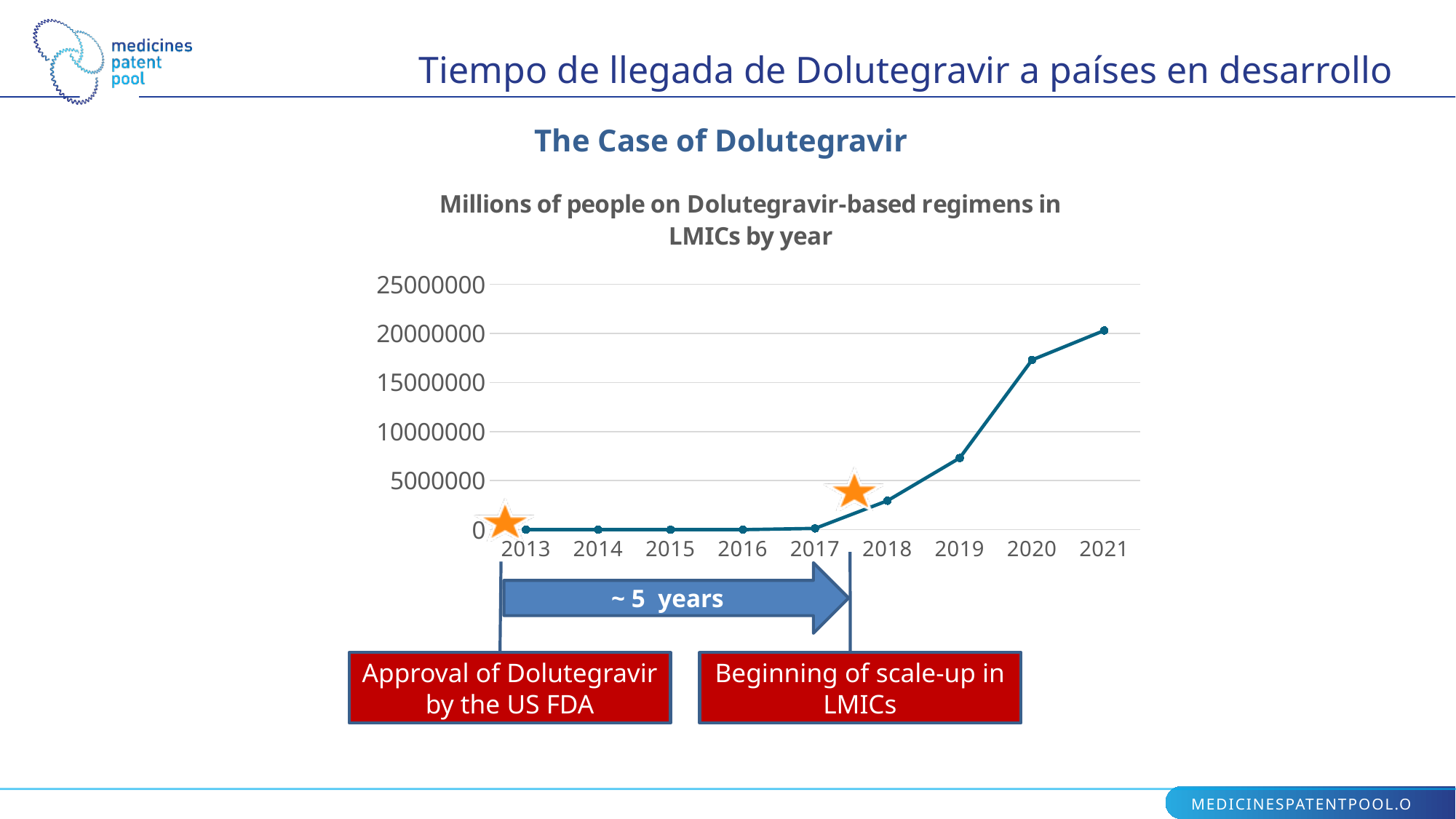
What kind of chart is shown on the slide? line chart Which year has the highest value on the chart? 2021 How many years are plotted along the x axis of the chart? 9 Is the value for 2019 greater or less than 10000000? less Is the value for 2020 greater or less than 15000000? greater Is the value for 2018 greater or less than 5000000? less Which is larger, the value for 2019 or the value for 2020? 2020 Do the values rise or fall along the x axis from 2017 to 2021? rise What is the title of the chart? Millions of people on Dolutegravir-based regimens in LMICs by year What is the highest value shown on the y axis of the chart? 25000000 Which is larger, the value for 2018 or the value for 2019? 2019